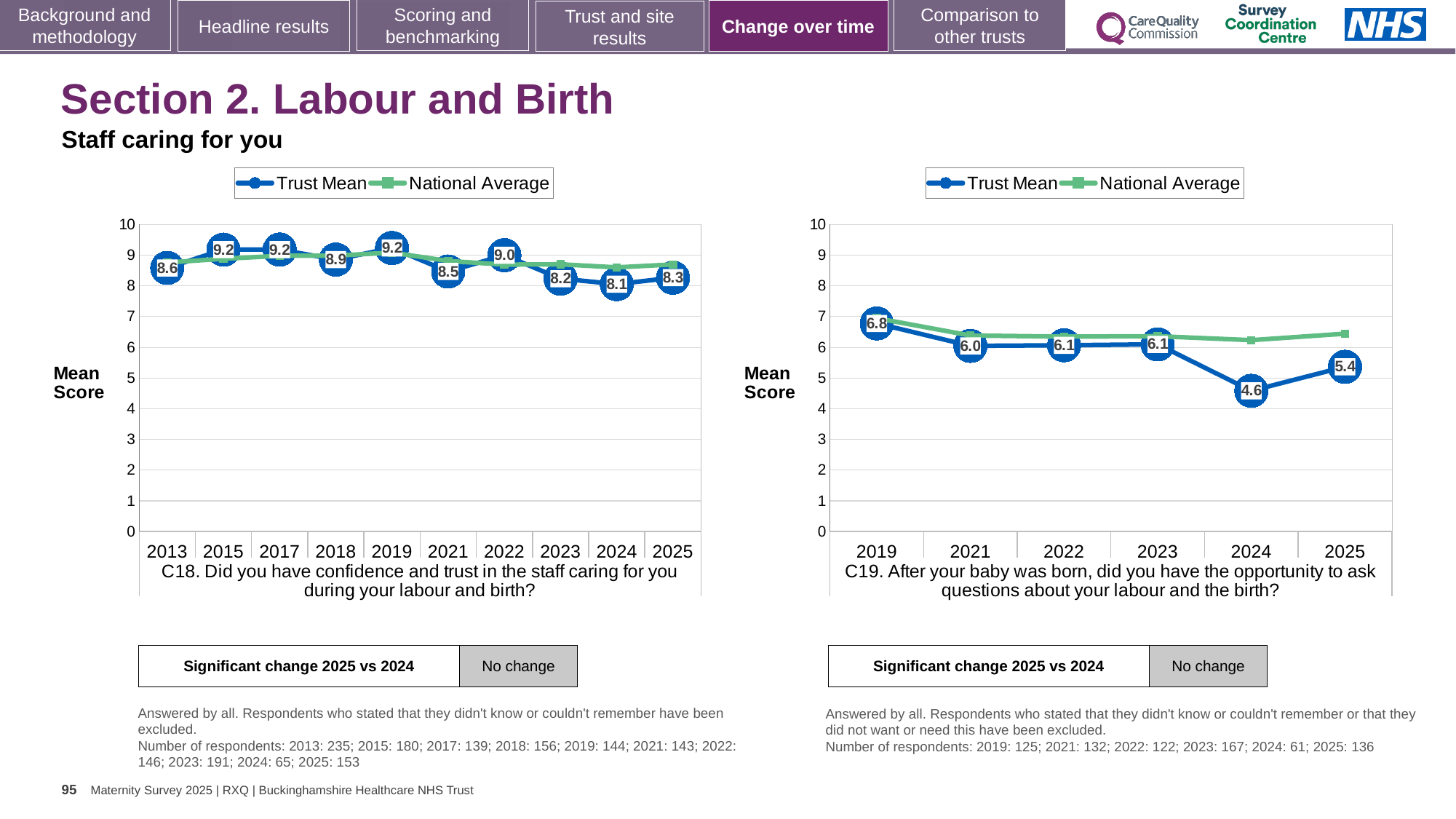
On the C18 chart (left), what is the difference between the Trust Mean scores for 2022 and 2023? 0.8 On the C18 chart (left), is the Trust Mean score higher in 2018 or in 2021? 2018 On the C19 chart (right), what is the Trust Mean score for 2024? 4.6 On the C19 chart (right), is the National Average for 2025 greater or less than 6? greater How many years are plotted on the C19 chart (right)? 6 On the C18 chart (left), what is the Trust Mean score for 2025? 8.3 On the C19 chart (right), which year has the highest Trust Mean score? 2019 How many series does the legend of the C18 chart (left) list? 2 On the C19 chart (right), which year has the lowest Trust Mean score? 2024 What type of chart is the C18 chart (left)? Line chart On the C18 chart (left), which year has the lowest Trust Mean score? 2024 On the C19 chart (right), what is the difference between the Trust Mean scores for 2019 and 2024? 2.2